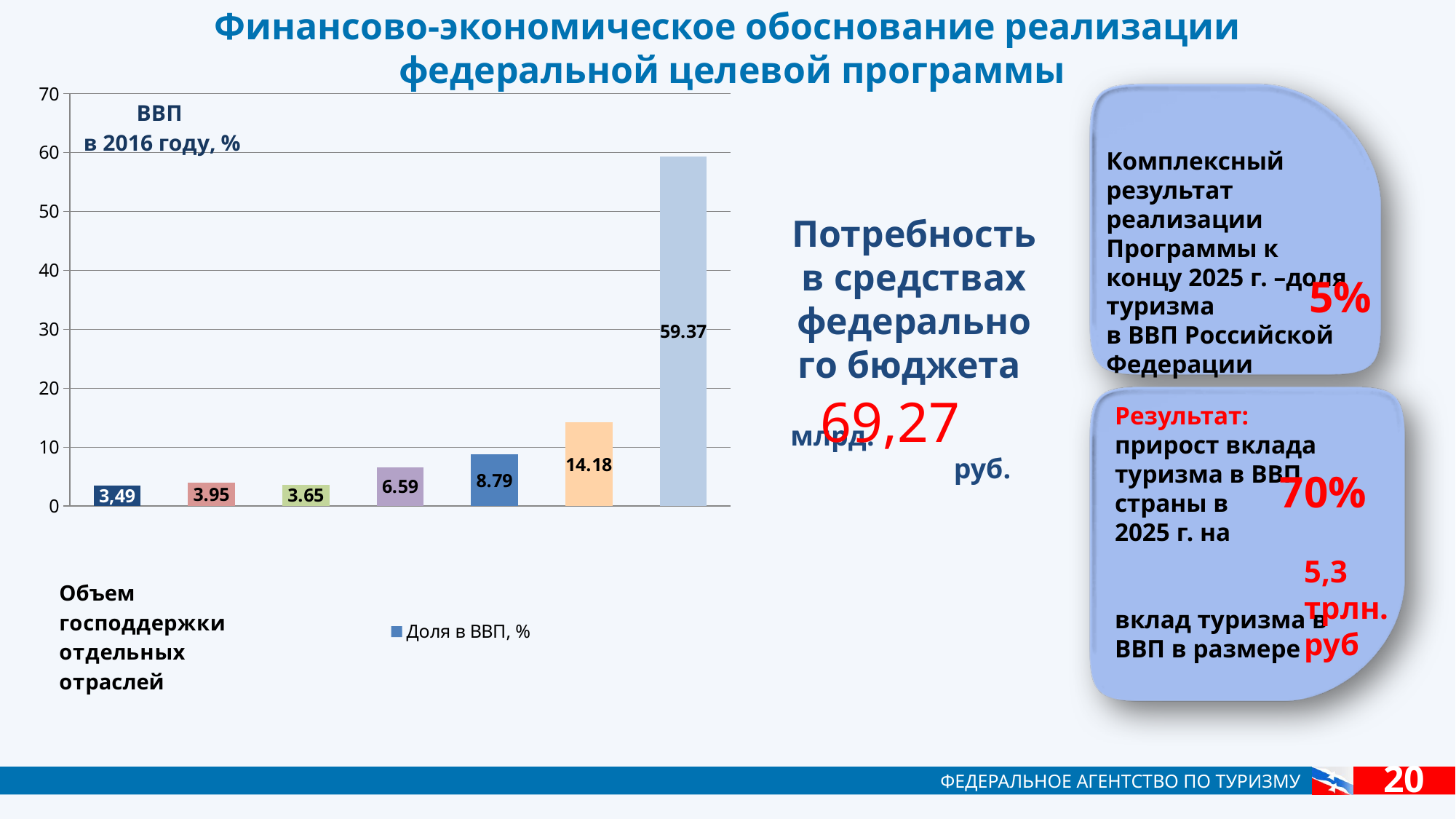
Is the value of the tallest bar greater or less than 50? greater What is the difference between the tallest bar (59.37) and the second tallest bar (14.18)? 45.19 How many series does the chart legend list? 1 Which is larger: the fifth bar from the left (8.79) or the fourth bar from the left (6.59)? the fifth bar (8.79) What is the value shown on the shortest bar in the chart? 3,49 What is the value shown on the tallest bar in the chart? 59.37 What is the value shown on the green bar (third from the left)? 3.65 What is the value shown on the orange bar (sixth from the left)? 14.18 What kind of chart is shown on the slide? bar chart What is the legend entry of the chart? Доля в ВВП, % What is the value shown on the purple bar (fourth from the left)? 6.59 How many bars are plotted in the chart? 7